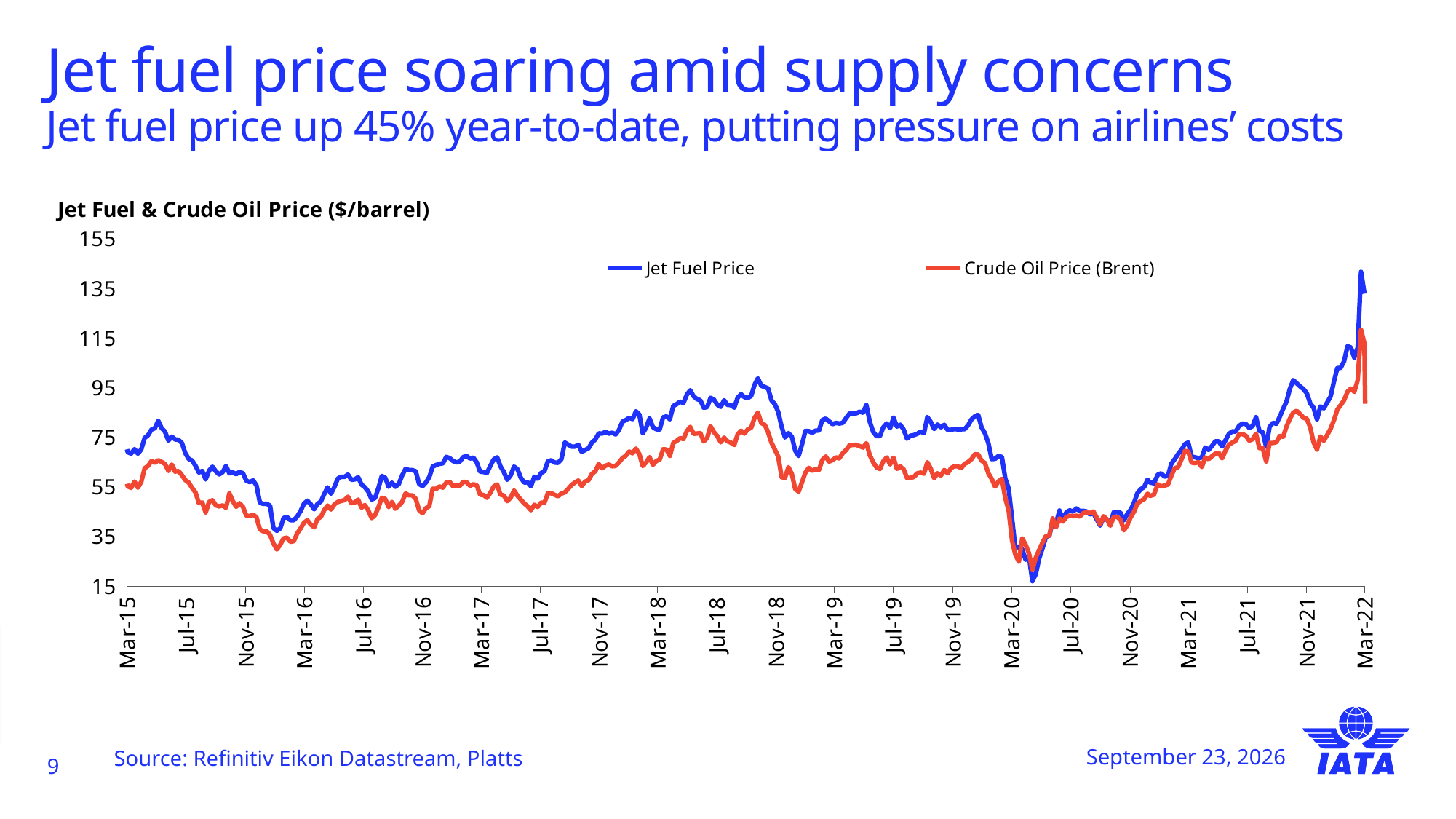
Which series is drawn in blue? Jet Fuel Price Is the Crude Oil Price (Brent) at its peak around Mar-22 greater or less than 95? greater Is the Jet Fuel Price at its peak around Mar-22 greater or less than 115? greater Is the Jet Fuel Price at its lowest point around Apr-20 greater or less than 35? less How many series does the chart legend list? 2 Does the Crude Oil Price (Brent) rise or fall between Nov-19 and Mar-20? Fall Does the Jet Fuel Price rise or fall between Nov-20 and Mar-22? Rise How many date labels are shown on the x axis? 22 What is the title of the chart? Jet Fuel & Crude Oil Price ($/barrel) What kind of chart is shown on the slide? Line chart Which series reaches the higher value at the Mar-22 peak, Jet Fuel Price or Crude Oil Price (Brent)? Jet Fuel Price